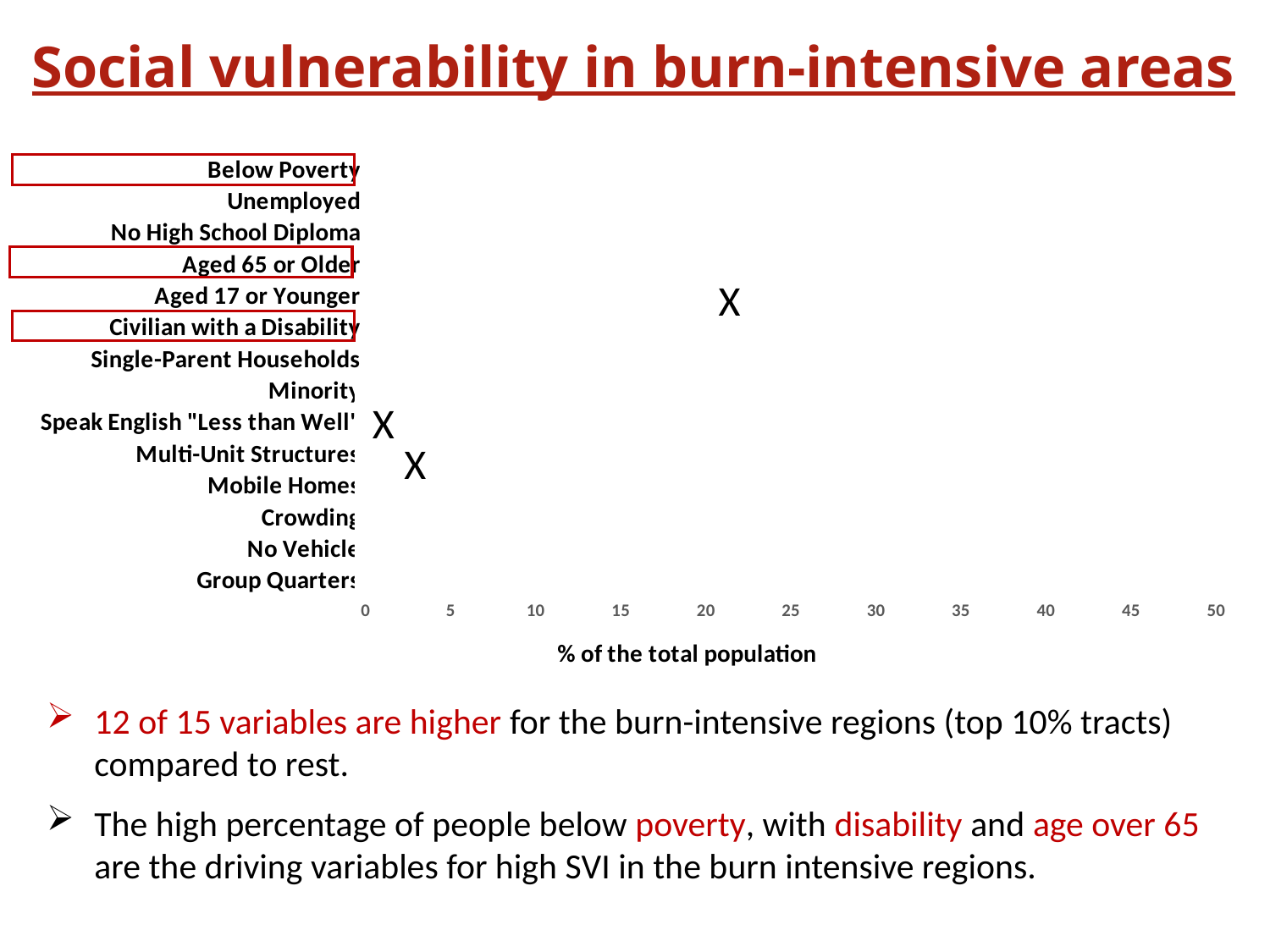
Is the X marker plotted next to Speak English "Less than Well" at a value greater or less than 5? less What is the title of the horizontal axis of the chart? % of the total population How many X markers are plotted on the chart? 3 What is the last (bottom) category listed on the vertical axis of the chart? Group Quarters What is the spacing between consecutive tick values on the horizontal axis of the chart? 5 Is the X marker plotted farthest to the right on the chart at a value greater or less than 15? greater Is the X marker plotted farthest to the right on the chart at a value greater or less than 30? less What is the first (top) category listed on the vertical axis of the chart? Below Poverty What is the highest tick value shown on the horizontal axis of the chart? 50 How many category labels are listed on the vertical axis of the chart? 14